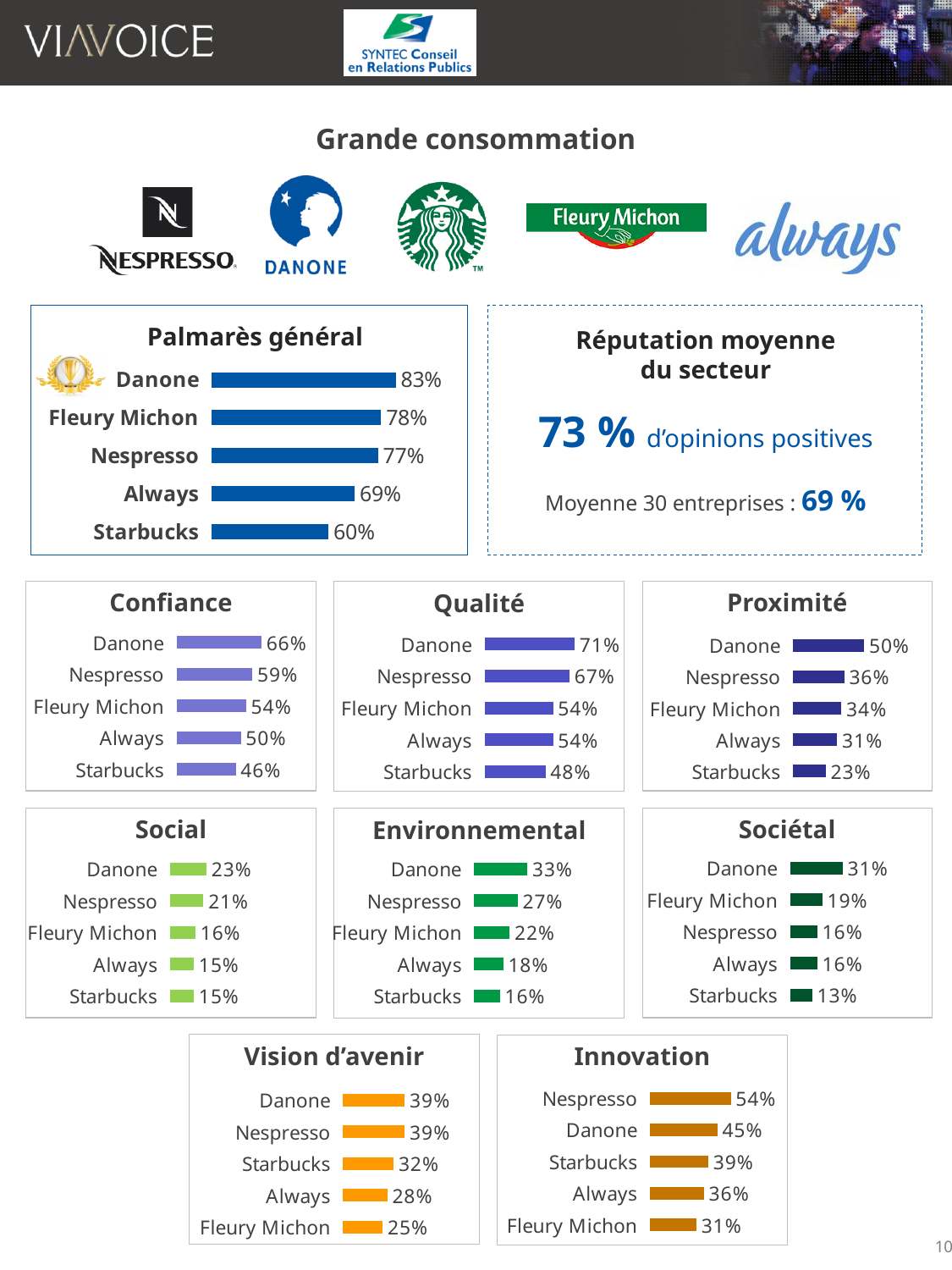
In the 'Environnemental' chart, what is the value for Always? 18% In the 'Confiance' chart, what is the value for Nespresso? 59% In the 'Sociétal' chart, how many companies are shown? 5 In the 'Qualité' chart, which company has the highest value? Danone In the 'Vision d'avenir' chart, what is the value for Fleury Michon? 25% In the 'Innovation' chart, which company has the highest value? Nespresso In the 'Palmarès général' chart, which company has the lowest value? Starbucks In the 'Palmarès général' chart, what is the difference between Fleury Michon and Always? 9% In the 'Proximité' chart, what is the difference between Danone and Starbucks? 27% In the 'Social' chart, which is larger, the value for Danone or the value for Fleury Michon? Danone In the 'Palmarès général' chart, what is the value for Danone? 83% What type of chart is the 'Palmarès général' chart? Bar chart